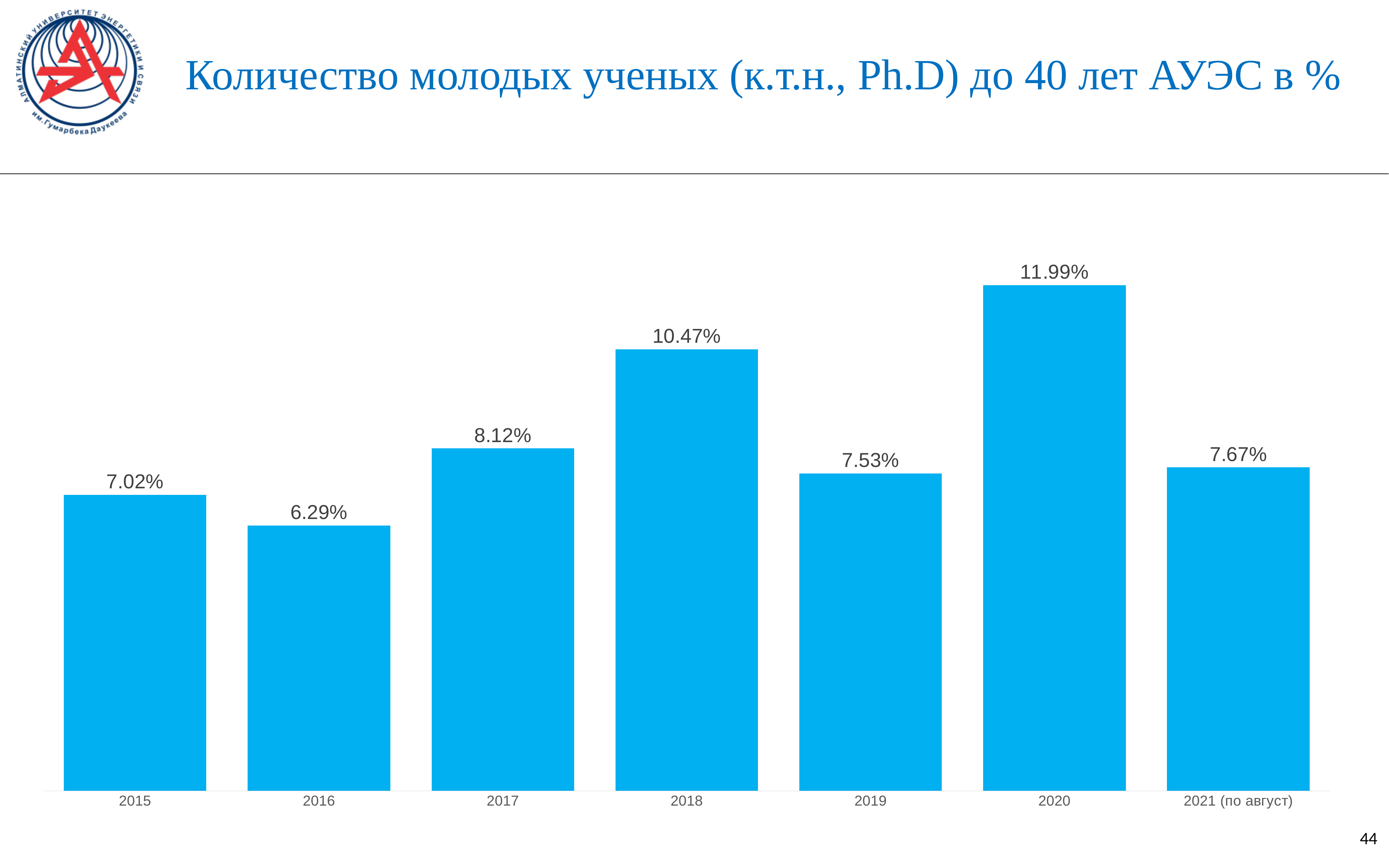
Which year has the highest value? 2020 How many years are shown on the x axis? 7 Which is larger, the value for 2018 or the value for 2017? 2018 What is the value for 2018? 10.47% Does the value rise or fall from 2018 to 2019? fall What is the difference between the values for 2020 and 2019? 4.46% What is the value for 2021 (по август)? 7.67% What is the title of the slide? Количество молодых ученых (к.т.н., Ph.D) до 40 лет АУЭС в % What kind of chart is shown on the slide? bar chart Which year has the lowest value? 2016 What is the value for 2016? 6.29% What is the difference between the values for 2017 and 2015? 1.10%